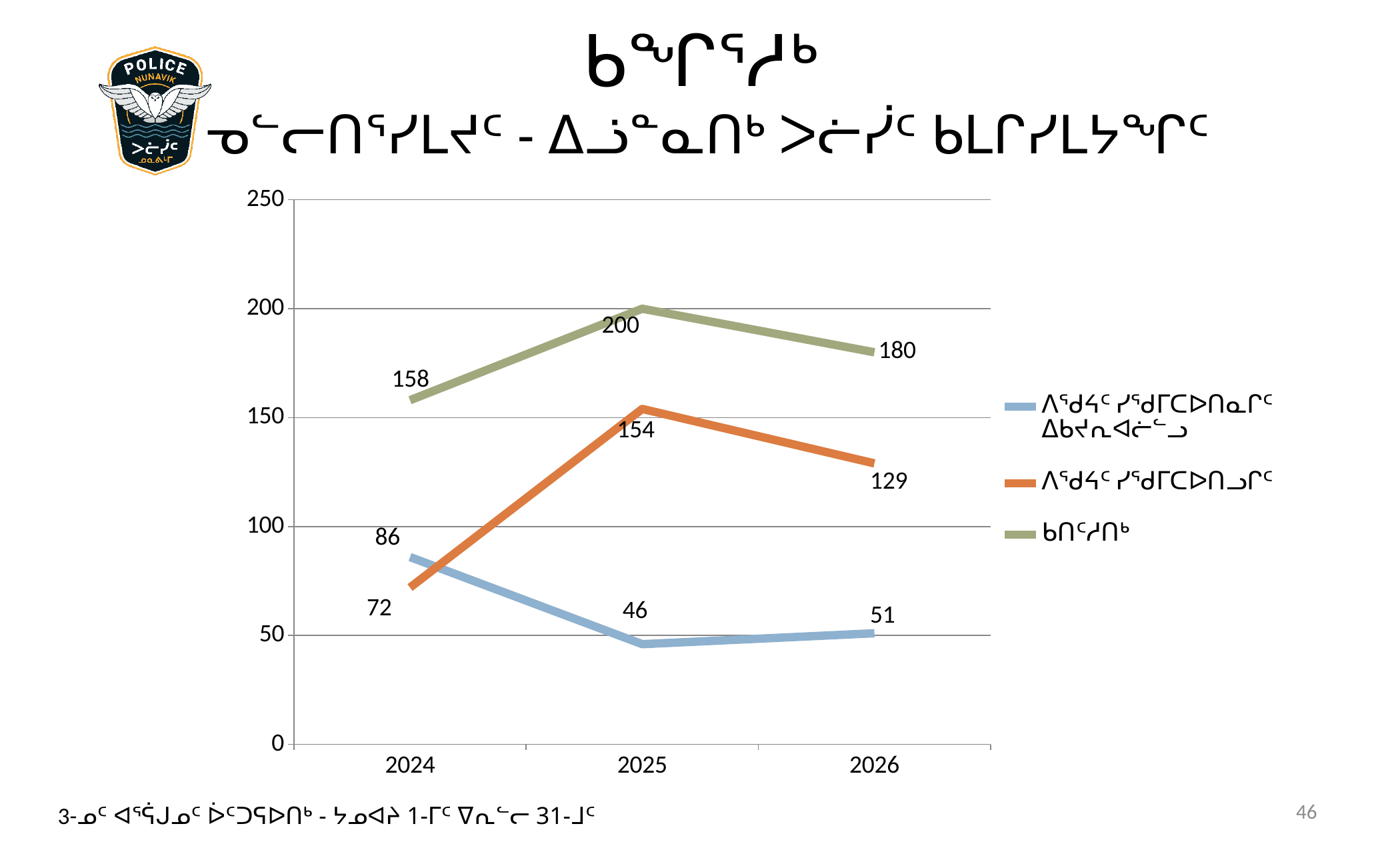
In which year does the orange line reach its highest value? 2025 Which is larger in 2024: the blue line's value or the orange line's value? the blue line (86) What kind of chart is shown on the slide? line chart How many series does the legend list? 3 What is the difference between the green line's value in 2025 and its value in 2024? 42 What is the value of the blue line in 2024? 86 In which year does the blue line reach its lowest value? 2025 What is the value of the orange line in 2026? 129 What is the value of the green line in 2025? 200 What is the difference between the orange line's value in 2025 and the blue line's value in 2025? 108 How many years are shown on the x axis? 3 Is the green line's value in 2026 greater or less than 150? greater